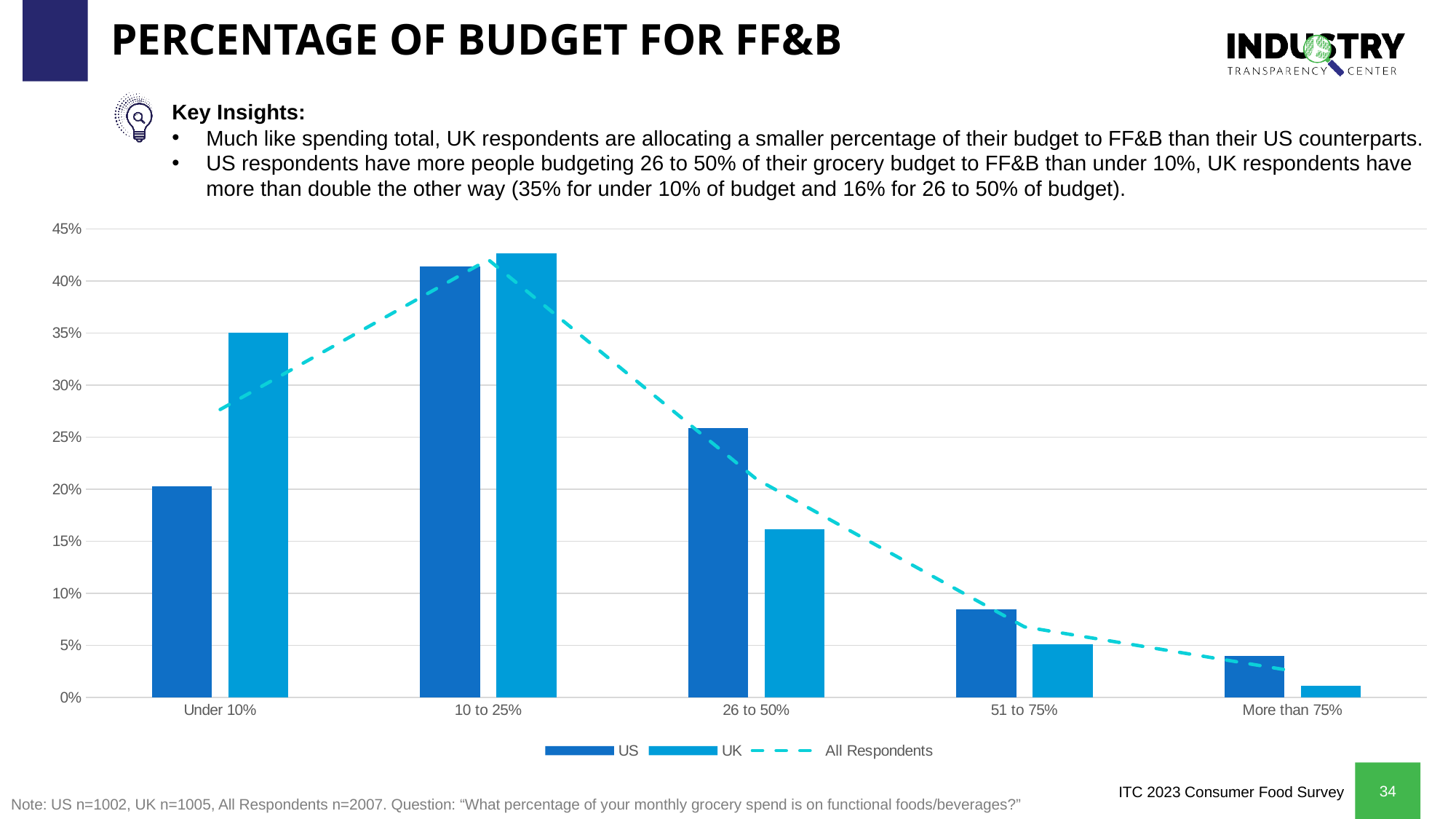
How many series does the legend list? 3 What kind of chart is shown on the slide? Combination bar and line chart Is the US value for Under 10% greater or less than 25%? less In the 26 to 50% category, which is larger, the US value or the UK value? US Which category has the lowest UK value? More than 75% Do the All Respondents values rise or fall from the 10 to 25% category to the More than 75% category? fall In the Under 10% category, which is larger, the US value or the UK value? UK What are the series listed in the legend? US, UK, All Respondents Which category has the highest US value? 10 to 25% Which category has the highest UK value? 10 to 25% How many budget categories are shown on the x axis? 5 What is the UK value for the Under 10% category? 35%